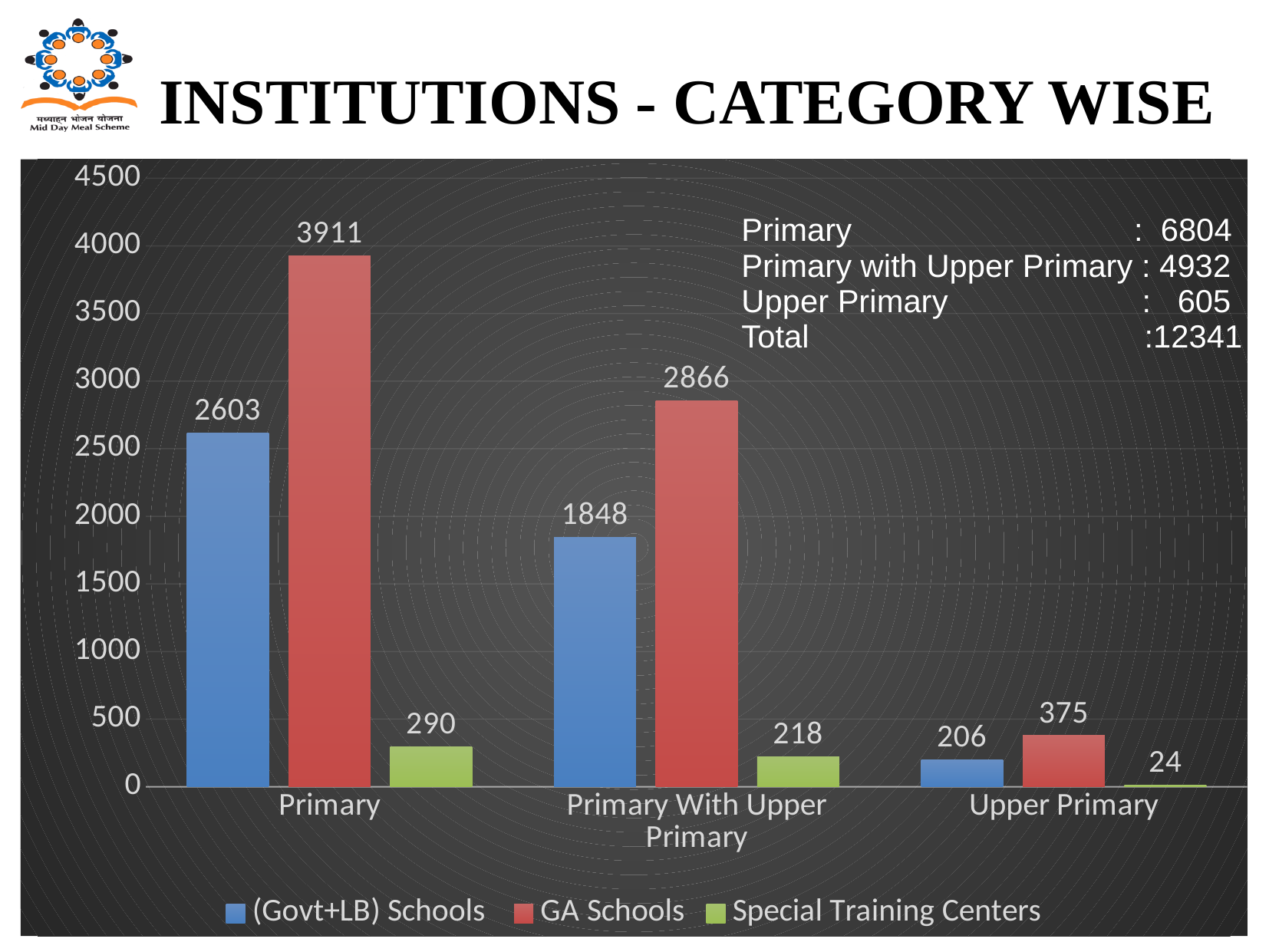
What is the value for GA Schools in the Primary category? 3911 Is the value for (Govt+LB) Schools in the Primary category greater or less than 2500? greater What kind of chart is shown on the slide? Bar chart What is the value for (Govt+LB) Schools in the Primary With Upper Primary category? 1848 Which category has the lowest value for (Govt+LB) Schools? Upper Primary Do the values for Special Training Centers rise or fall from Primary to Upper Primary? Fall What is the difference between GA Schools and (Govt+LB) Schools in the Primary category? 1308 Which category has the highest value for GA Schools? Primary How many categories are shown on the x axis? 3 How many series does the legend list? 3 What is the value for Special Training Centers in the Upper Primary category? 24 Which is larger in the Upper Primary category: GA Schools or (Govt+LB) Schools? GA Schools